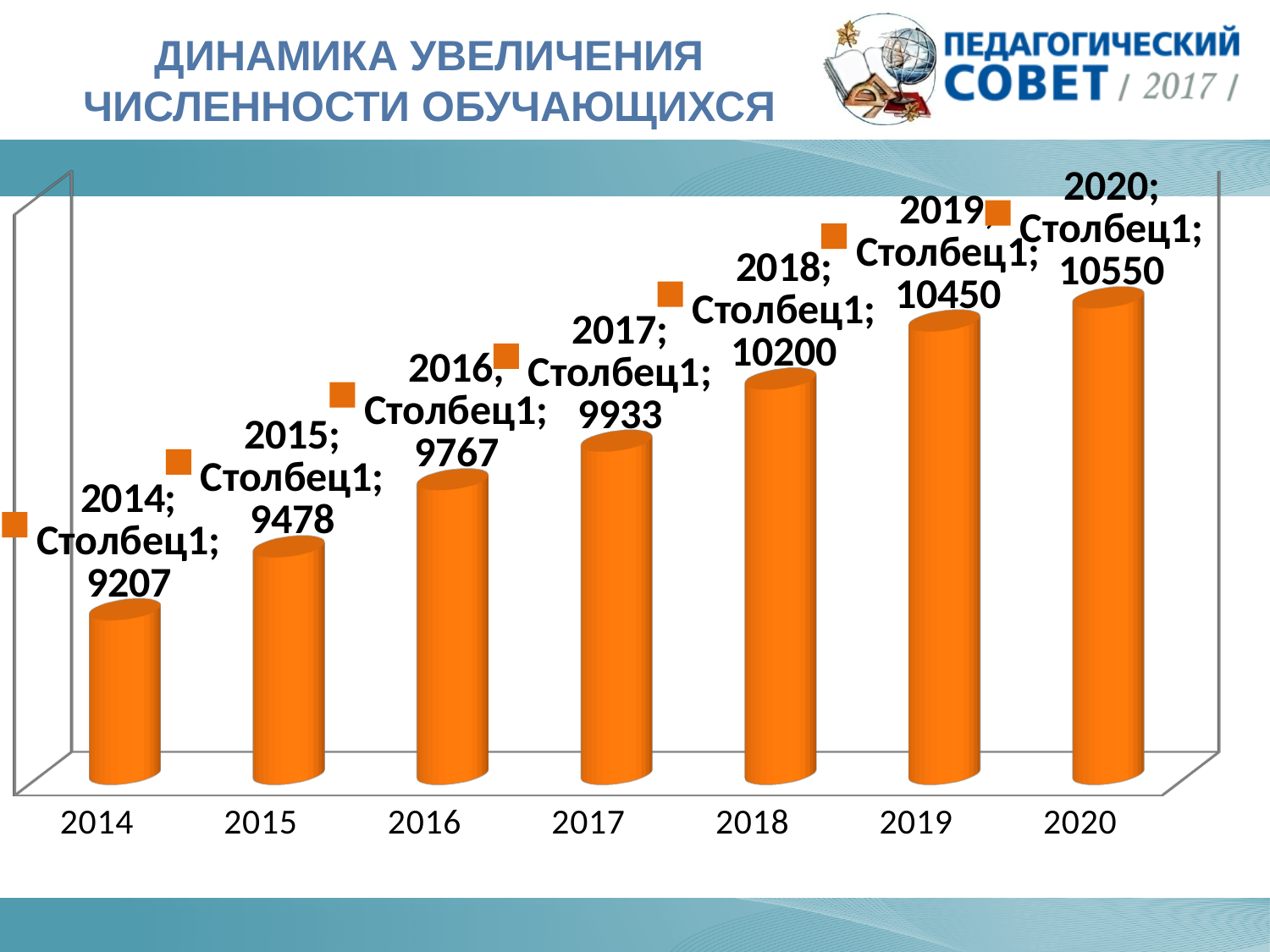
How many years are shown on the x axis? 7 What is the value for 2020? 10550 Do the values rise or fall from 2014 to 2020? rise What is the difference between the values for 2020 and 2014? 1343 Which year has the highest value? 2020 What kind of chart is shown on the slide? bar chart What is the series name shown in the data labels? Столбец1 What is the value for 2014? 9207 What is the value for 2017? 9933 What is the difference between the values for 2018 and 2017? 267 Which year has the lowest value? 2014 Which is larger, the value for 2016 or the value for 2019? 2019